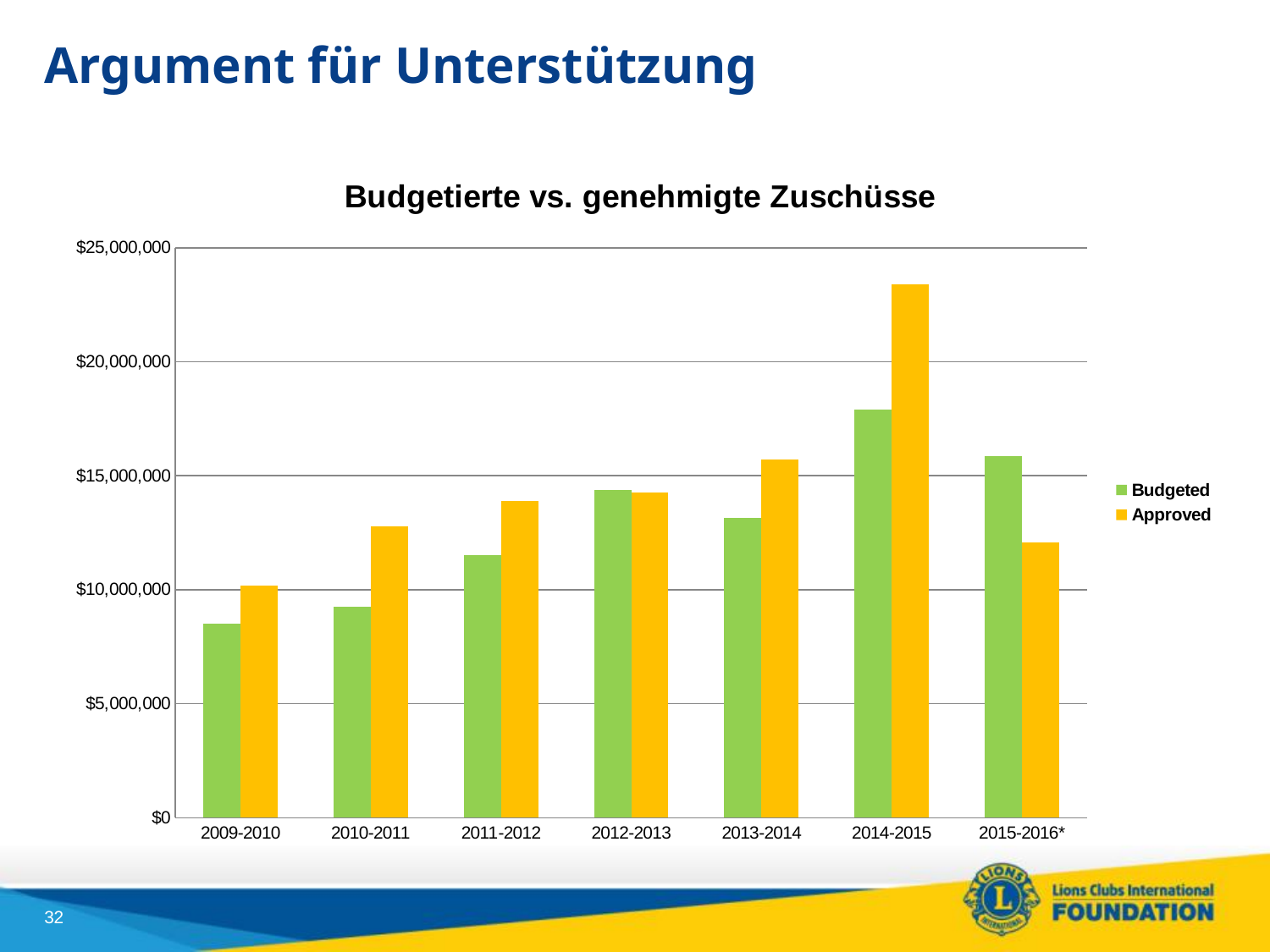
How many series does the legend list? 2 Is the Budgeted value for 2009-2010 greater or less than $10,000,000? less How many fiscal-year categories are shown on the x axis? 7 Does the Approved value rise or fall from 2009-2010 through 2014-2015? rise In which year is the Approved value highest? 2014-2015 In which year is the Approved value lowest? 2009-2010 What kind of chart is shown on the slide? bar chart What is the title of the chart? Budgetierte vs. genehmigte Zuschüsse Is the Approved value for 2014-2015 greater or less than $20,000,000? greater In which year is the Budgeted value lowest? 2009-2010 For 2015-2016*, which is larger, the Budgeted or the Approved value? Budgeted Is the Budgeted value for 2014-2015 greater or less than $15,000,000? greater